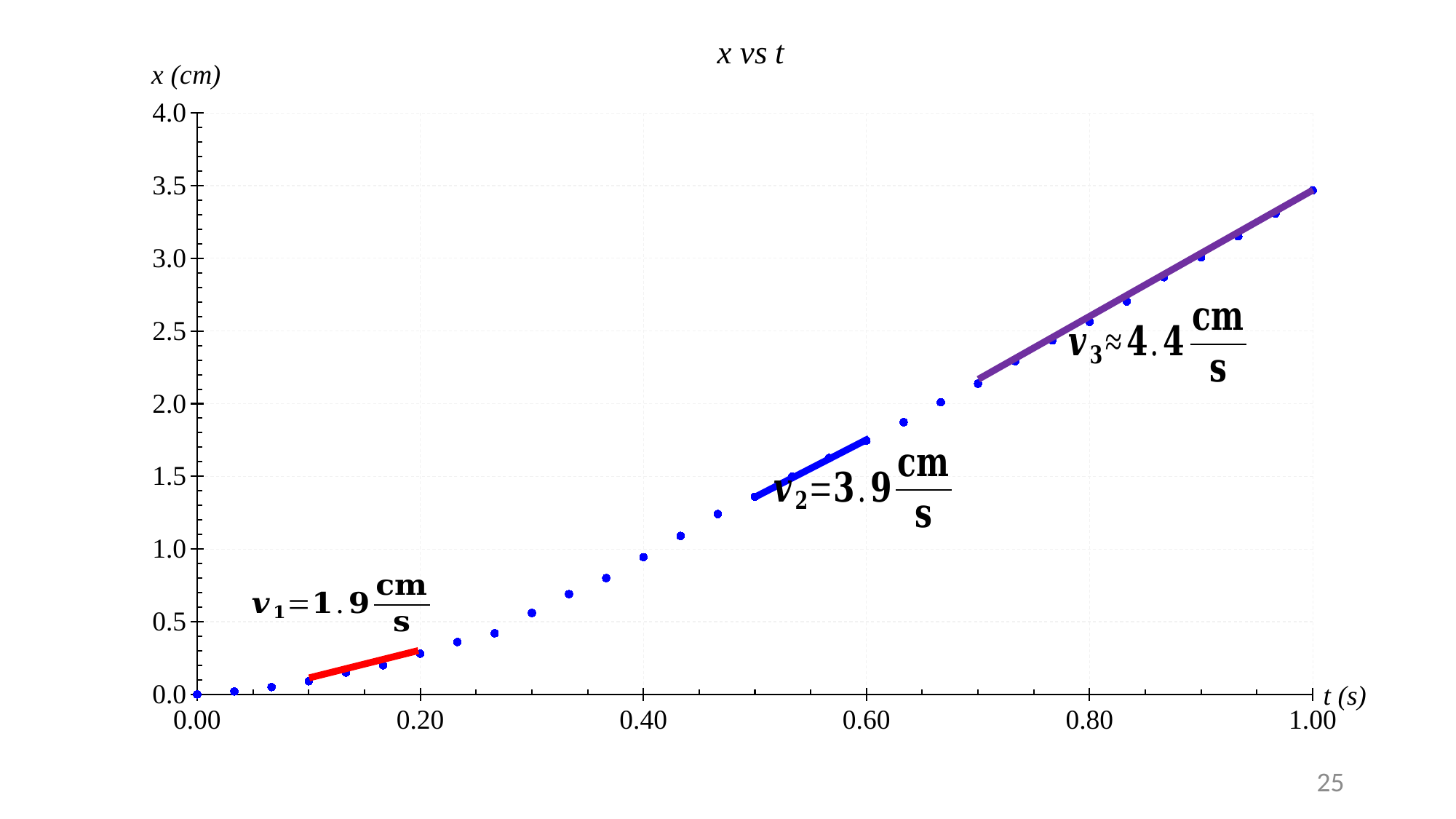
What is the label of the vertical axis? x (cm) What velocity is given for v1 on the chart? 1.9 cm/s Do the plotted x values rise or fall as t increases? Rise What kind of chart is shown on the slide? Scatter plot Is the value of x at t = 1.00 s greater or less than 3.0 cm? greater Is the value of x at t = 0.20 s greater or less than 0.5 cm? less Which of the labelled velocities, v1 or v3, is larger? v3 What is the title of the chart? x vs t What velocity is given for v2 on the chart? 3.9 cm/s What approximate velocity is given for v3 on the chart? 4.4 cm/s How many fitted line segments are drawn over the data points? 3 What is the difference between v2 and v1? 2.0 cm/s